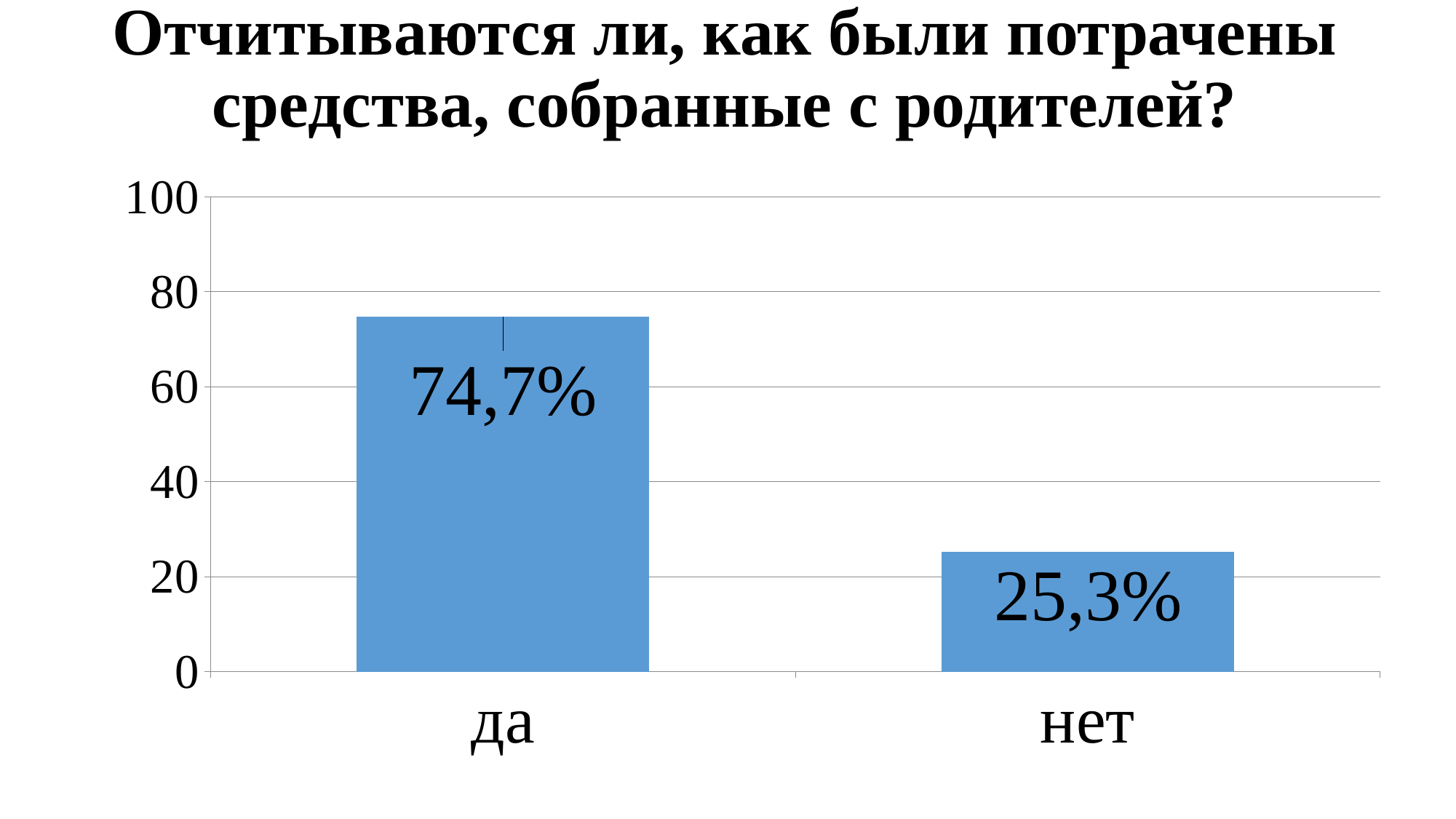
What is the difference between the values for "да" and "нет"? 49,4% What is the value for "да"? 74,7% Is the value for "нет" greater or less than 40? less Which is larger, the value for "да" or the value for "нет"? да How many categories are shown on the x axis? 2 Is the value for "да" greater or less than 60? greater What colour are the bars in the chart? blue What kind of chart is shown on the slide? bar chart What is the maximum value shown on the y axis? 100 What is the value for "нет"? 25,3% Which category has the highest value? да Which category has the lowest value? нет